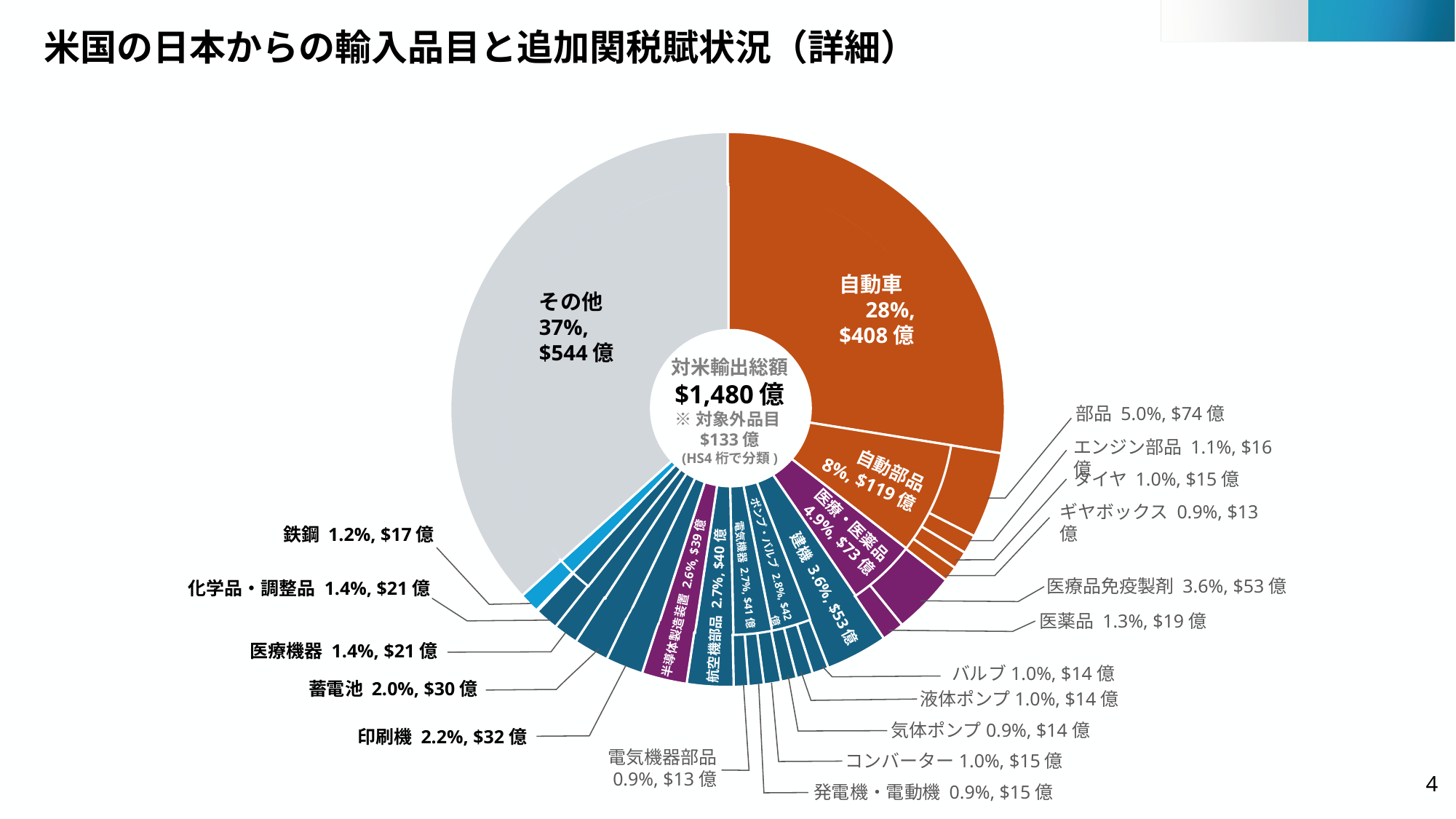
What is the value shown for 自動車? $408 億 What is the value shown for 自動部品? $119 億 What is the value shown for 医療品免疫製剤? $53 億 Which category has the largest slice of the pie? その他 Which is larger, the value for 建機 or the value for 医療・医薬品? 医療・医薬品 What percentage and value are shown for 鉄鋼? 1.2%, $17 億 What is the difference in value between その他 and 自動車? $136 億 What is the total export amount (対米輸出総額) shown in the centre of the chart? $1,480 億 What is the value shown for 部品 in the outer ring? $74 億 What kind of chart is shown on the slide? doughnut chart What share of the pie does 自動車 account for? 28% What is the value of 対象外品目 noted in the centre of the chart? $133 億